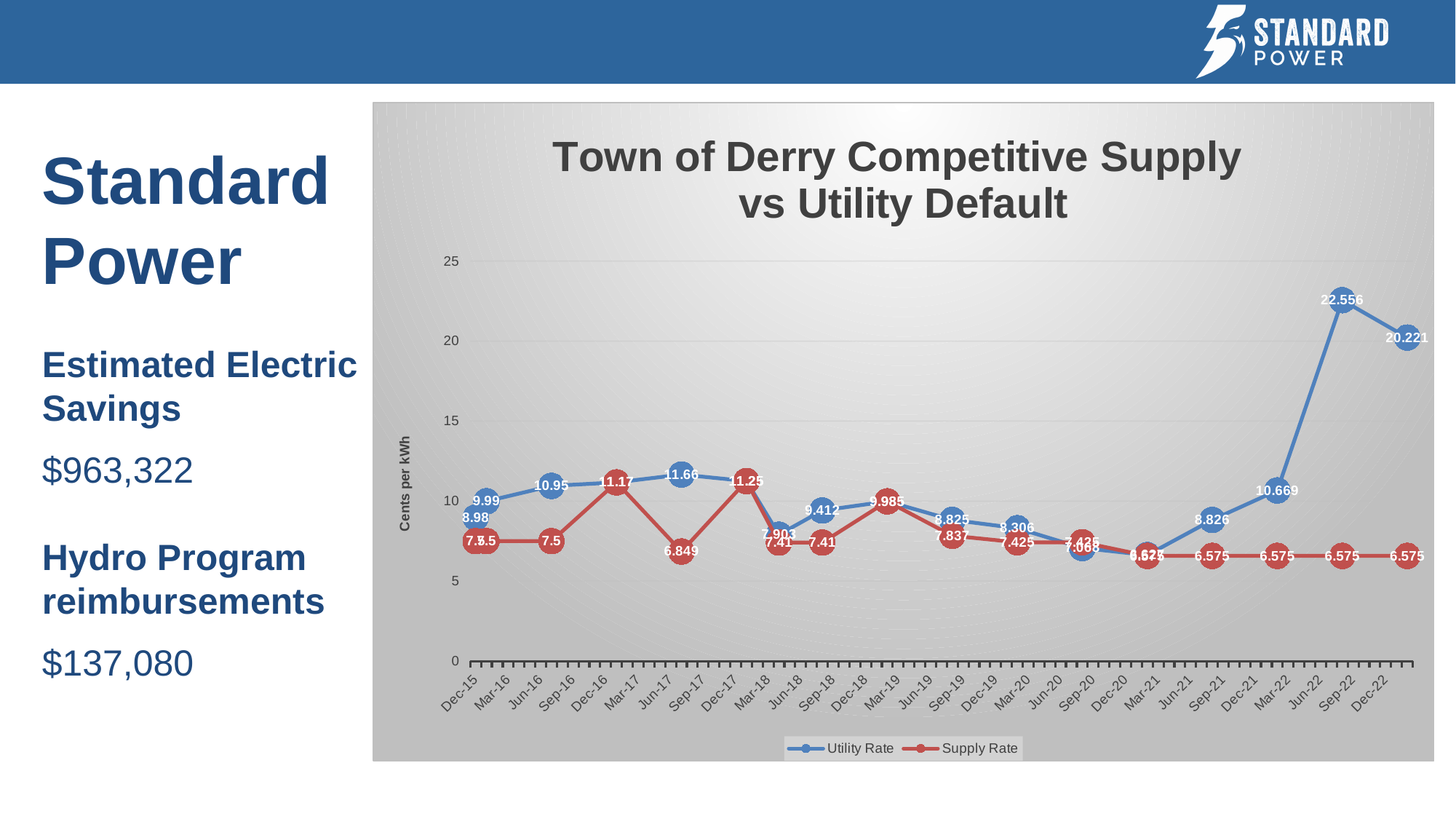
What is the title of the chart's vertical axis? Cents per kWh What is the Utility Rate value at Dec-22, the last point on the chart? 20.221 How many series does the chart's legend list? 2 At the last point on the chart (Dec-22), which series has the larger value, Utility Rate or Supply Rate? Utility Rate What is the highest Utility Rate value plotted on the chart? 22.556 What is the highest Supply Rate value plotted on the chart? 11.25 What is the Supply Rate value at Dec-22, the last point on the chart? 6.575 Is the peak Utility Rate value greater or less than 20? greater What is the difference between the two highest Utility Rate values, 22.556 and 20.221? 2.335 What kind of chart is shown on the slide? line chart What are the two series named in the chart's legend? Utility Rate and Supply Rate What is the lowest Supply Rate value plotted on the chart? 6.575